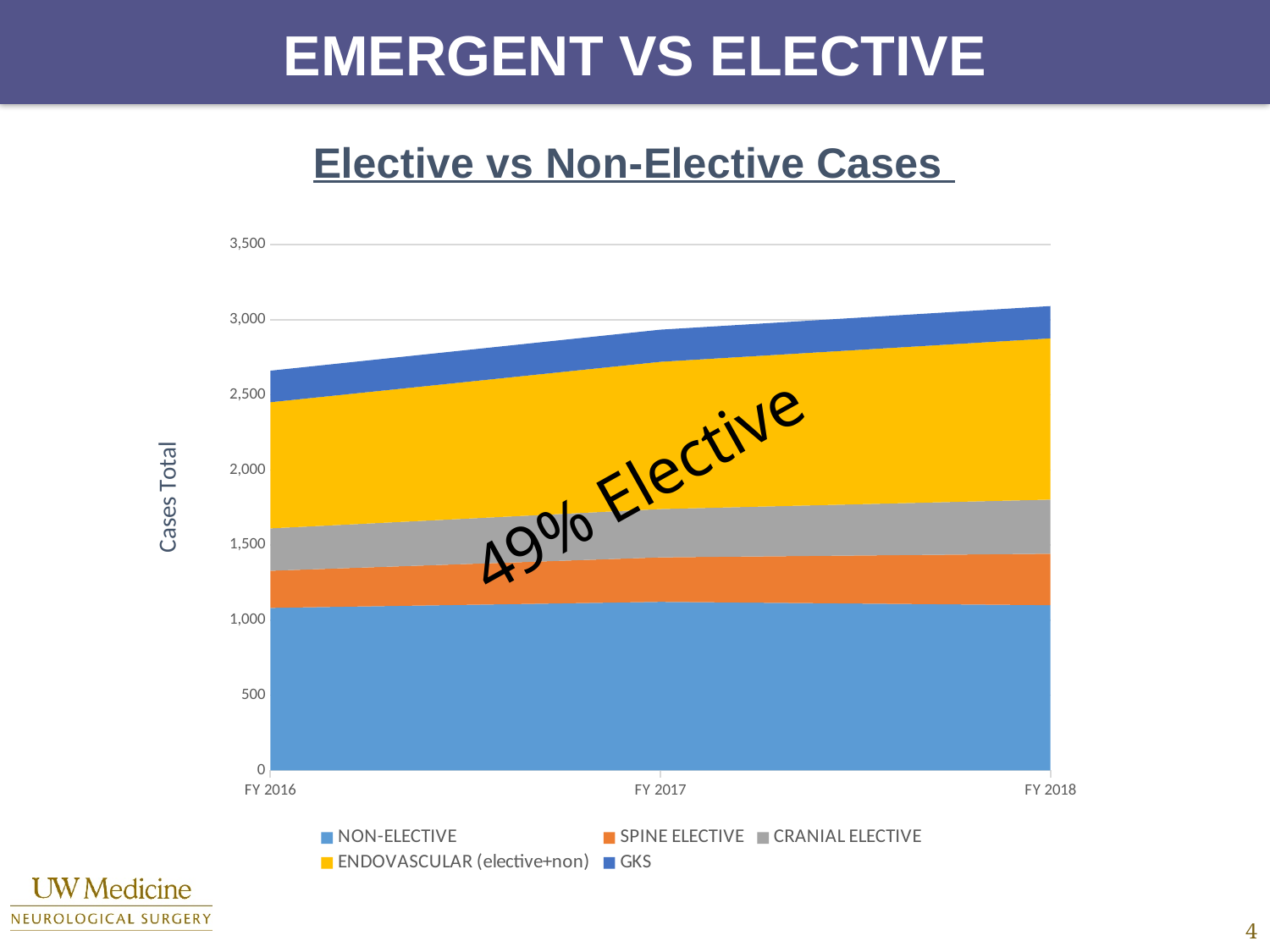
What is the label of the vertical axis? Cases Total Which fiscal year has the lowest total number of cases? FY 2016 Is the total number of cases in FY 2018 greater or less than 3,000? greater Which fiscal year has the highest total number of cases? FY 2018 What type of chart is shown on the slide? Stacked area chart Is the total number of cases in FY 2016 greater or less than 3,000? less What is the title of the chart? Elective vs Non-Elective Cases Is the number of NON-ELECTIVE cases in FY 2016 greater or less than 1,000? greater Does the total number of cases rise or fall from FY 2016 to FY 2018? Rise How many fiscal years are shown on the x axis? 3 How many series does the legend list? 5